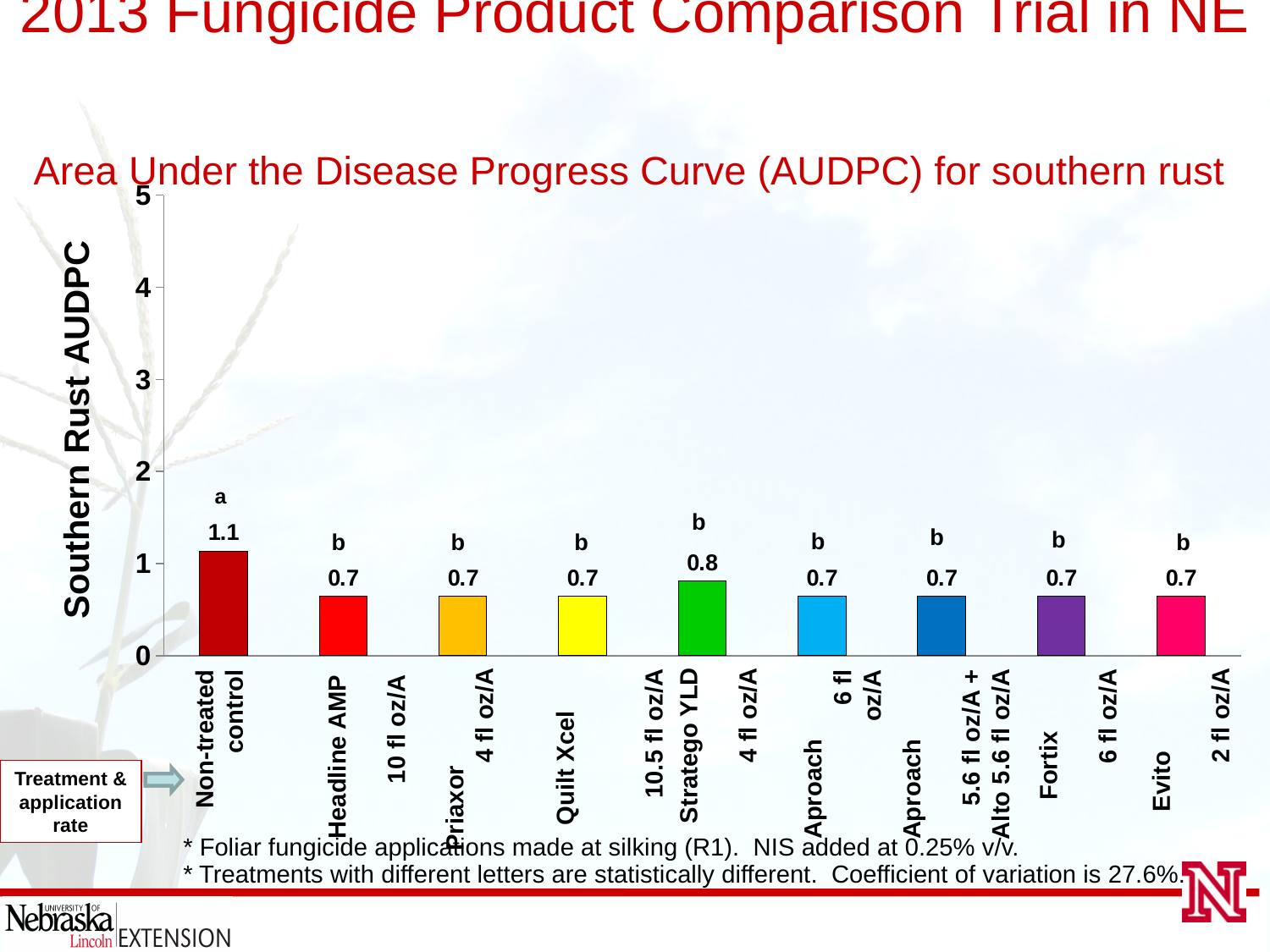
What type of chart is shown on the slide? Bar chart Which treatment has the highest Southern Rust AUDPC? Non-treated control What is the Southern Rust AUDPC value for Headline AMP at 10 fl oz/A? 0.7 What is the difference in Southern Rust AUDPC between Stratego YLD and Quilt Xcel? 0.1 What is the Southern Rust AUDPC value for Stratego YLD at 4 fl oz/A? 0.8 What is the label on the vertical axis of the chart? Southern Rust AUDPC Is the Southern Rust AUDPC value for Stratego YLD greater or less than 1? less What is the Southern Rust AUDPC value for Evito at 2 fl oz/A? 0.7 What is the difference in Southern Rust AUDPC between the Non-treated control and Fortix at 6 fl oz/A? 0.4 How many treatments are plotted in the chart? 9 Which has a larger Southern Rust AUDPC, the Non-treated control or Priaxor at 4 fl oz/A? Non-treated control What is the Southern Rust AUDPC value for the Non-treated control? 1.1